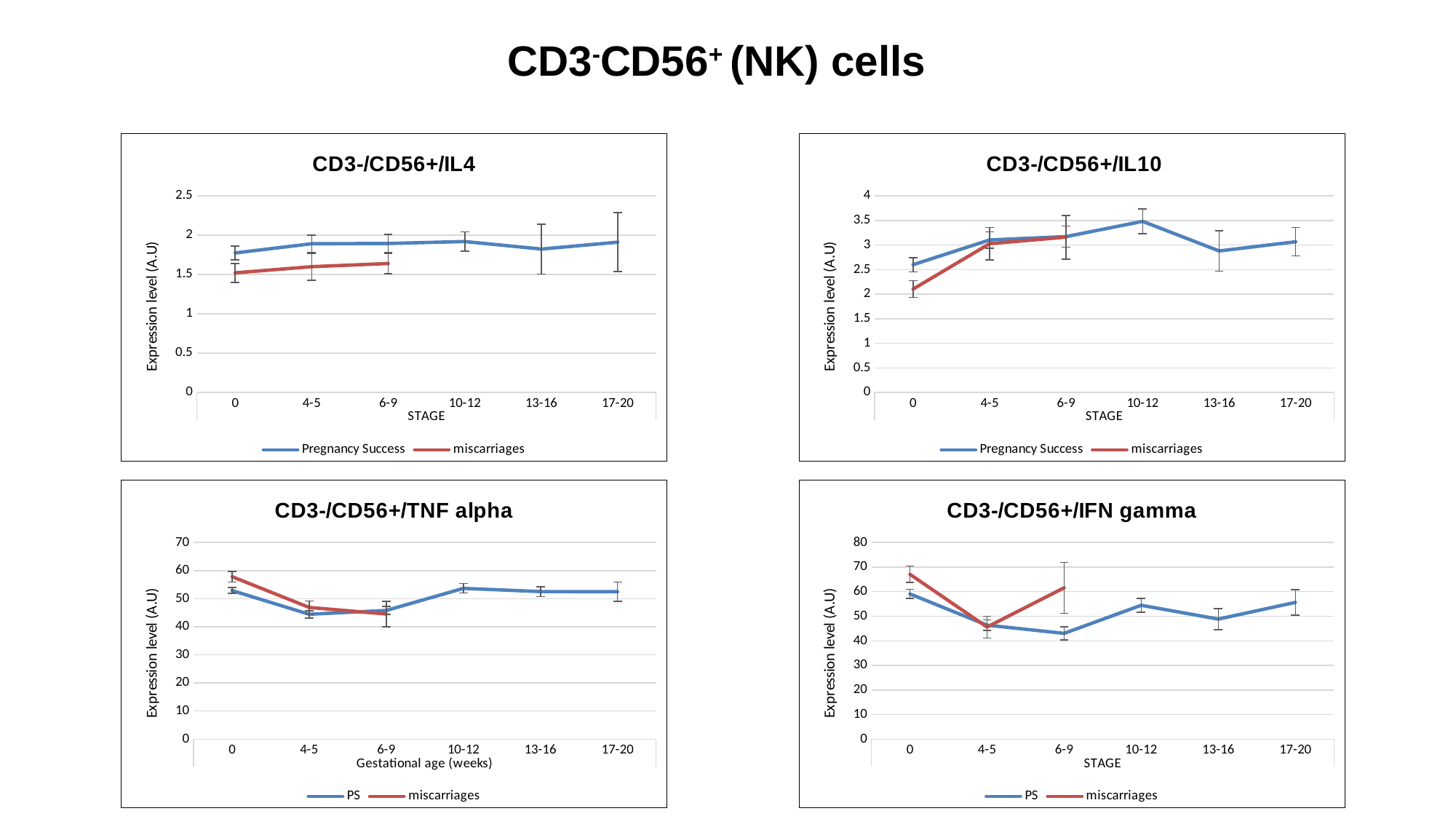
How many series does the legend of the CD3-/CD56+/IL10 chart list? 2 What kind of chart is the CD3-/CD56+/IL4 chart? line chart In the CD3-/CD56+/IL10 chart, at which stage is the Pregnancy Success value lowest? 0 In the CD3-/CD56+/IL10 chart, at which stage is the Pregnancy Success value highest? 10-12 In the CD3-/CD56+/IL4 chart, is the Pregnancy Success value at stage 0 greater or less than 1.5? greater In the CD3-/CD56+/IFN gamma chart, which series has the higher value at stage 6-9, PS or miscarriages? miscarriages What is the x-axis title of the CD3-/CD56+/TNF alpha chart? Gestational age (weeks) In the CD3-/CD56+/IL10 chart, is the miscarriages value at stage 0 greater or less than 2.5? less In the CD3-/CD56+/TNF alpha chart, is the PS value at stage 10-12 greater or less than 50? greater In the CD3-/CD56+/TNF alpha chart, which series has the higher value at stage 0, PS or miscarriages? miscarriages In the CD3-/CD56+/IL10 chart, does the Pregnancy Success line rise or fall from stage 0 to stage 4-5? rise How many stage categories are shown on the x axis of the CD3-/CD56+/TNF alpha chart? 6